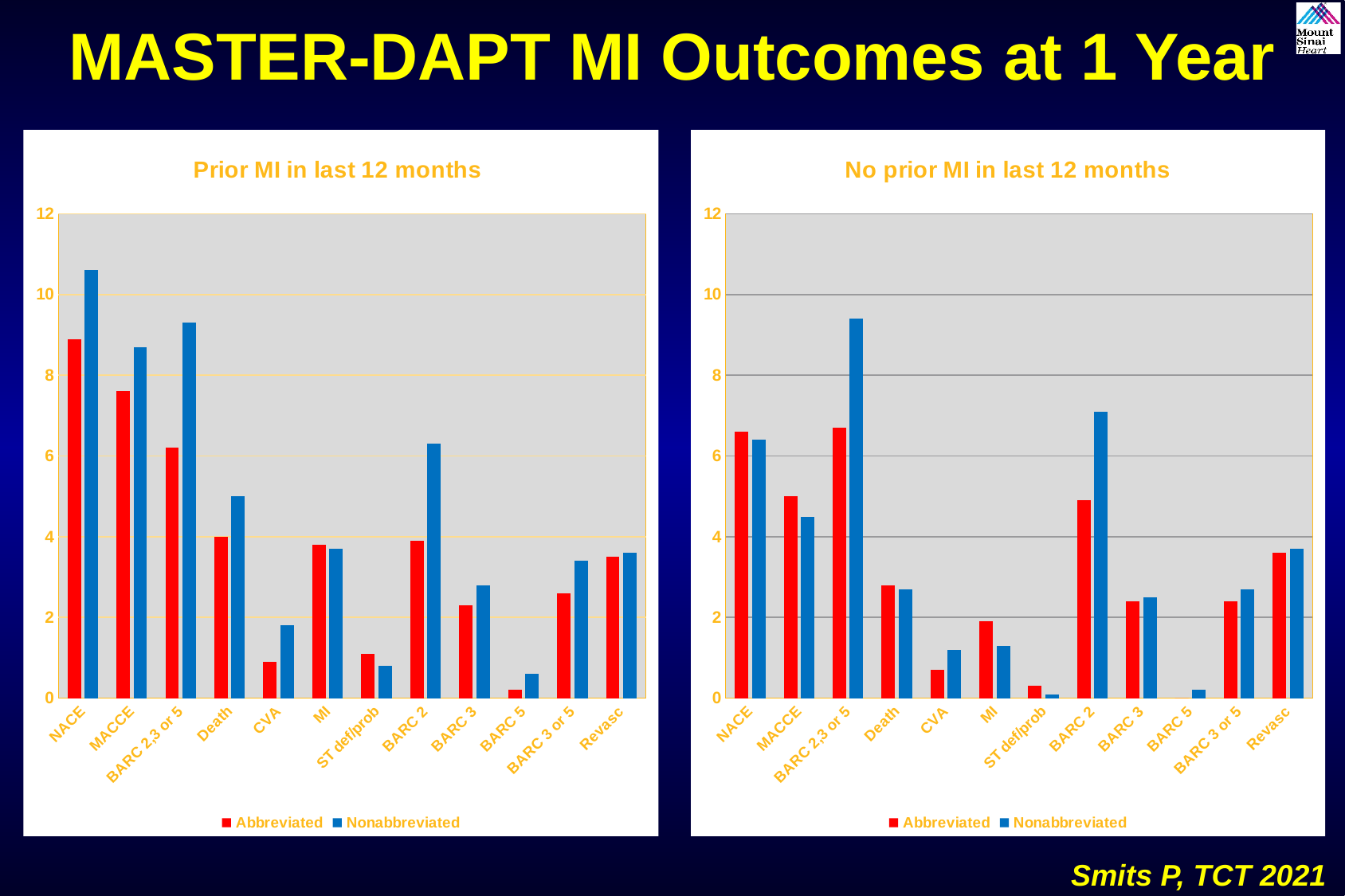
In the 'Prior MI in last 12 months' chart, for BARC 2, which series has the larger value, Abbreviated or Nonabbreviated? Nonabbreviated In the 'Prior MI in last 12 months' chart, what colour represents the Abbreviated series? red In the 'Prior MI in last 12 months' chart, is the Nonabbreviated value for NACE greater or less than 10? greater In the 'No prior MI in last 12 months' chart, is the Abbreviated value for Death greater or less than 2? greater In the 'No prior MI in last 12 months' chart, for MI, which series has the larger value, Abbreviated or Nonabbreviated? Abbreviated How many series does the legend of the 'No prior MI in last 12 months' chart list? 2 In the 'Prior MI in last 12 months' chart, which category has the lowest Abbreviated value? BARC 5 In the 'No prior MI in last 12 months' chart, is the Nonabbreviated value for BARC 2,3 or 5 greater or less than 8? greater How many categories are shown on the x axis of the 'Prior MI in last 12 months' chart? 12 In the 'No prior MI in last 12 months' chart, which category has the highest Nonabbreviated value? BARC 2,3 or 5 What kind of chart is the 'Prior MI in last 12 months' chart? bar chart In the 'Prior MI in last 12 months' chart, which category has the highest Nonabbreviated value? NACE